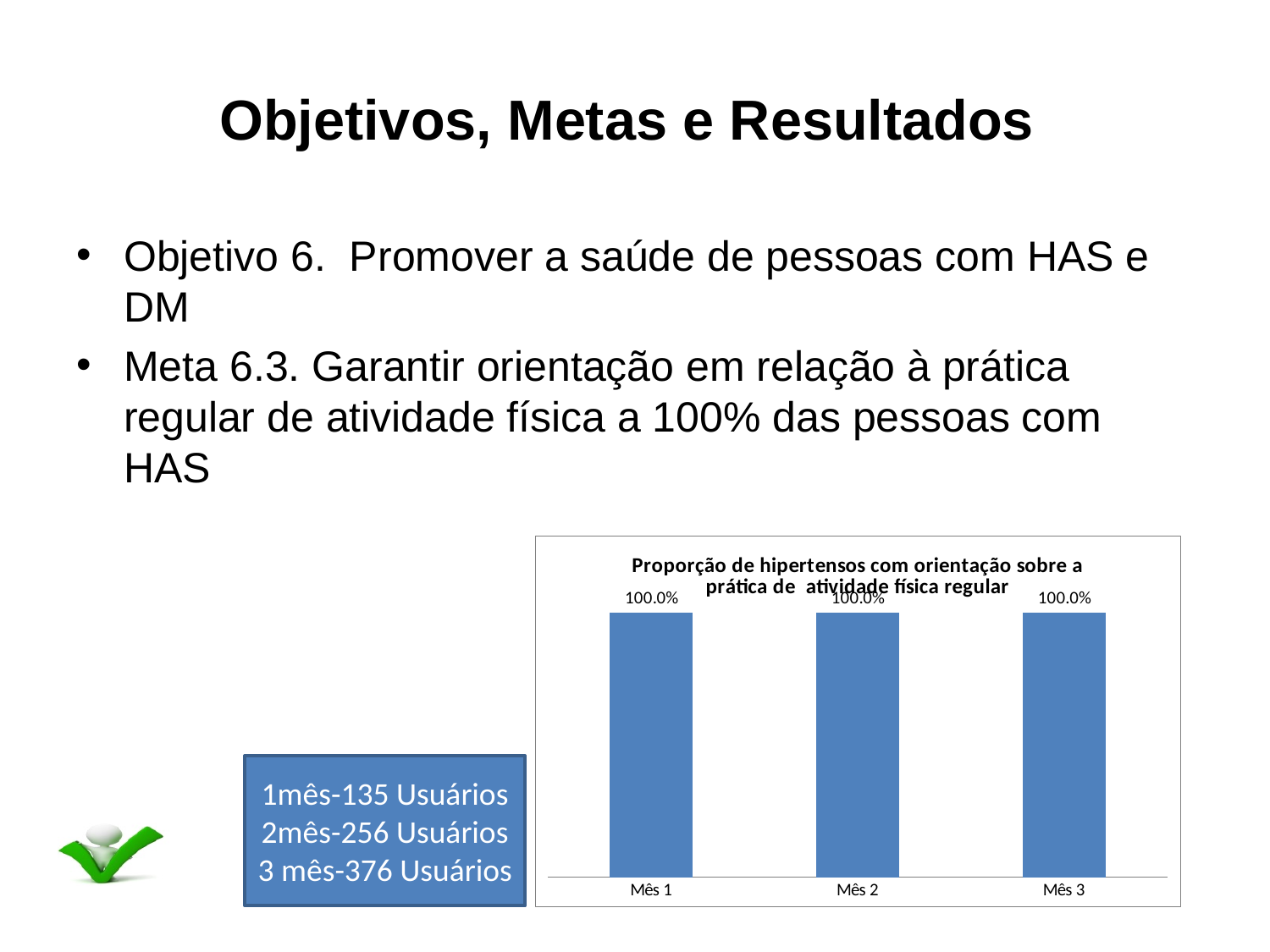
What is the value for Mês 3? 100.0% Do the values rise, fall, or stay the same from Mês 1 to Mês 3? Stay the same What is the value for Mês 2? 100.0% What is the value for Mês 1? 100.0% What kind of chart is shown on the slide? Bar chart What colour are the bars in the chart? Blue What is the difference between the values for Mês 1 and Mês 3? 0.0% How many categories are shown on the x axis of the chart? 3 What is the title of the chart? Proporção de hipertensos com orientação sobre a prática de atividade física regular Are the values for Mês 1 and Mês 2 equal? Yes